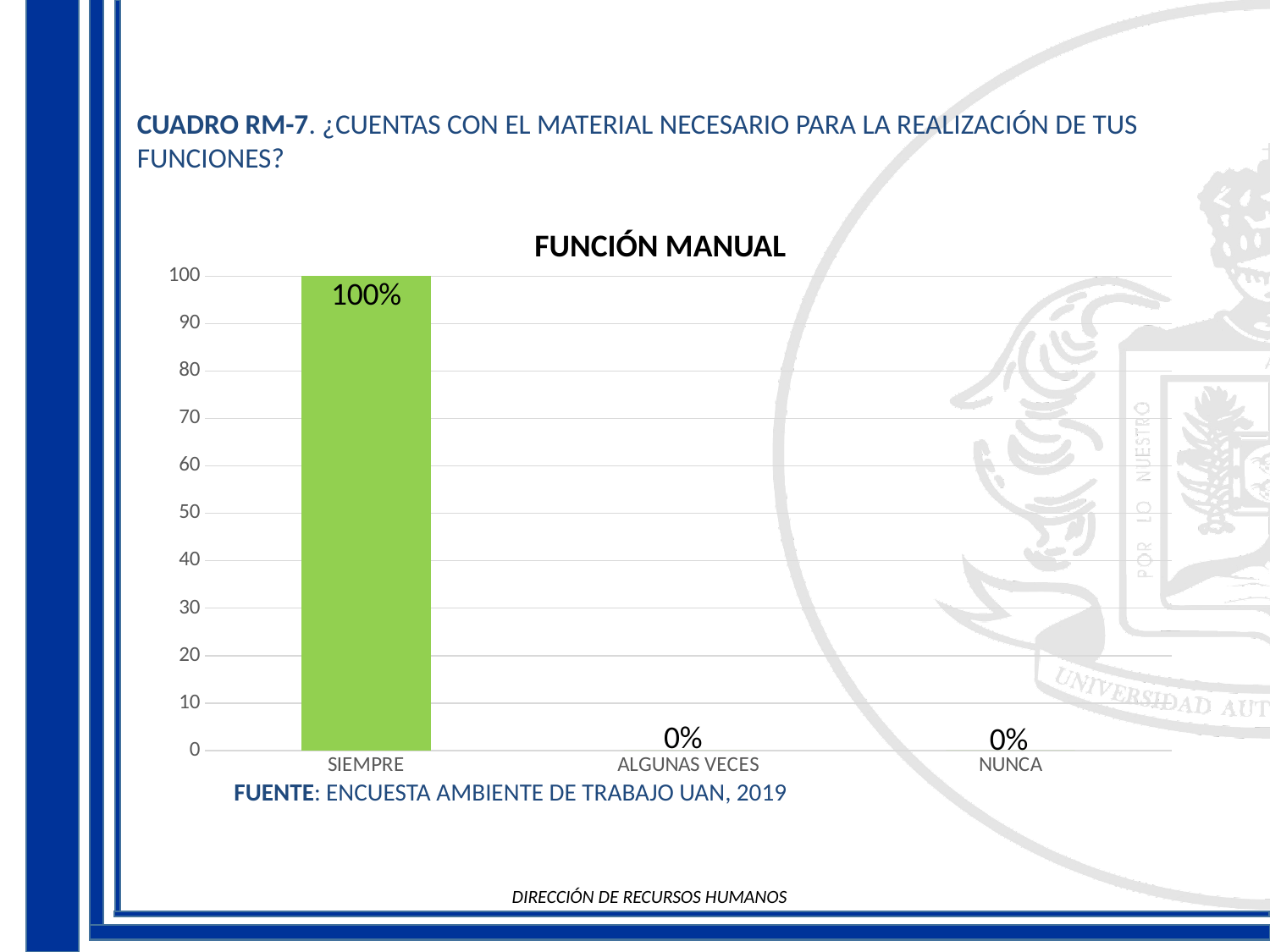
Do the values rise or fall from SIEMPRE to NUNCA along the x axis? fall What colour is the bar for SIEMPRE? green What is the difference between the values for SIEMPRE and NUNCA? 100% How many categories are shown on the x axis? 3 Which is larger, the value for SIEMPRE or the value for ALGUNAS VECES? SIEMPRE Which category has the highest value? SIEMPRE What is the value for SIEMPRE? 100% What kind of chart is shown on the slide? bar chart What is the value for ALGUNAS VECES? 0% Is the value for SIEMPRE greater or less than 50? greater What is the title of the chart? FUNCIÓN MANUAL What is the value for NUNCA? 0%